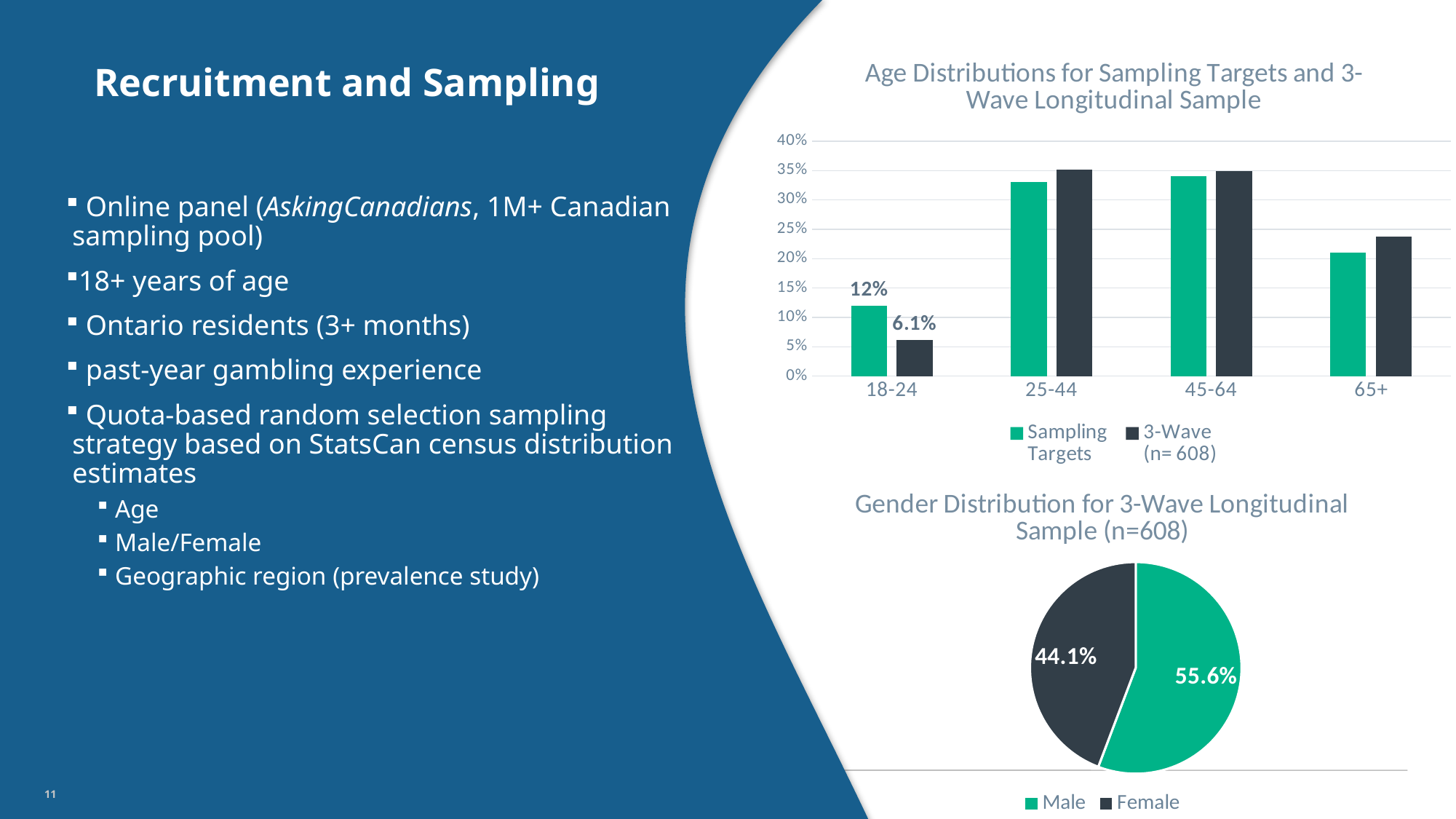
In the Age Distributions chart, is the Sampling Targets value for the 65+ age group greater or less than 25%? less In the Age Distributions chart, which age group has the lowest 3-Wave value? 18-24 In the Age Distributions chart, what is the Sampling Targets value for the 18-24 age group? 12% In the Age Distributions chart, which series has the larger value for the 18-24 age group, Sampling Targets or 3-Wave? Sampling Targets In the Gender Distribution pie chart, which slice is larger, Male or Female? Male How many series does the legend of the Age Distributions chart list? 2 How many age groups are shown in the Age Distributions chart? 4 In the Age Distributions chart, what is the difference between the Sampling Targets and 3-Wave values for the 18-24 age group? 5.9 percentage points In the Age Distributions chart, is the 3-Wave value for the 25-44 age group greater or less than 30%? greater In the Age Distributions chart, what is the 3-Wave (n= 608) value for the 18-24 age group? 6.1% In the Gender Distribution pie chart, what share is Male? 55.6% What kind of chart is the Age Distributions for Sampling Targets and 3-Wave Longitudinal Sample chart? bar chart